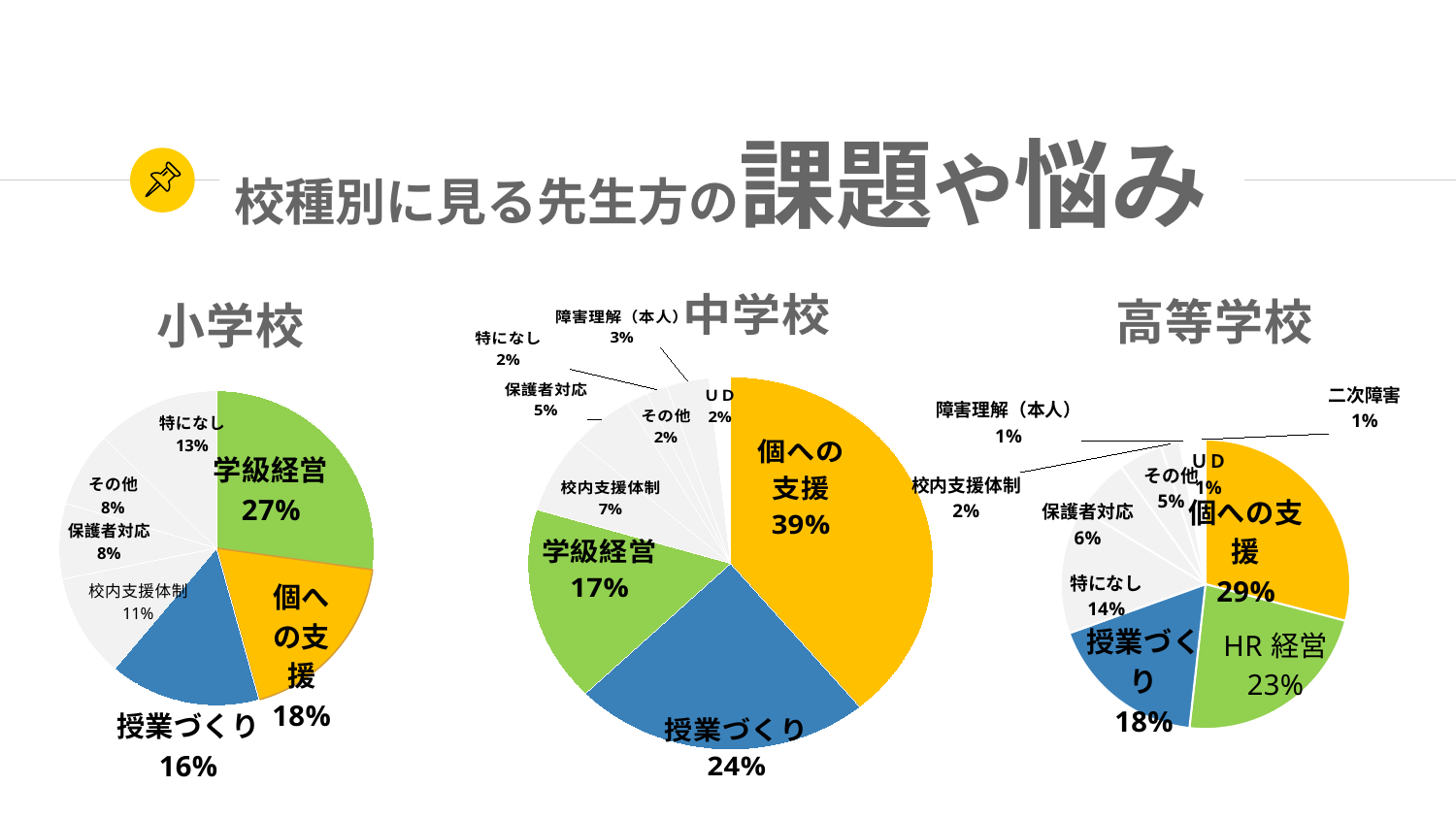
What type of chart is used for 中学校? Pie chart In the 高等学校 pie chart, which category has the largest share? 個への支援 In the 中学校 pie chart, which category has the largest share? 個への支援 In the 小学校 pie chart, which is larger, 個への支援 or 授業づくり? 個への支援 In the 中学校 pie chart, what percentage is shown for 個への支援? 39% In the 高等学校 pie chart, what percentage is shown for HR 経営? 23% In the 中学校 pie chart, what is the difference between 個への支援 and 授業づくり? 15% In the 高等学校 pie chart, what percentage is shown for 特になし? 14% In the 小学校 pie chart, what percentage is shown for 学級経営? 27% In the 小学校 pie chart, which category has the largest share? 学級経営 How many slices does the 小学校 pie chart have? 7 How many pie charts are on the slide? 3